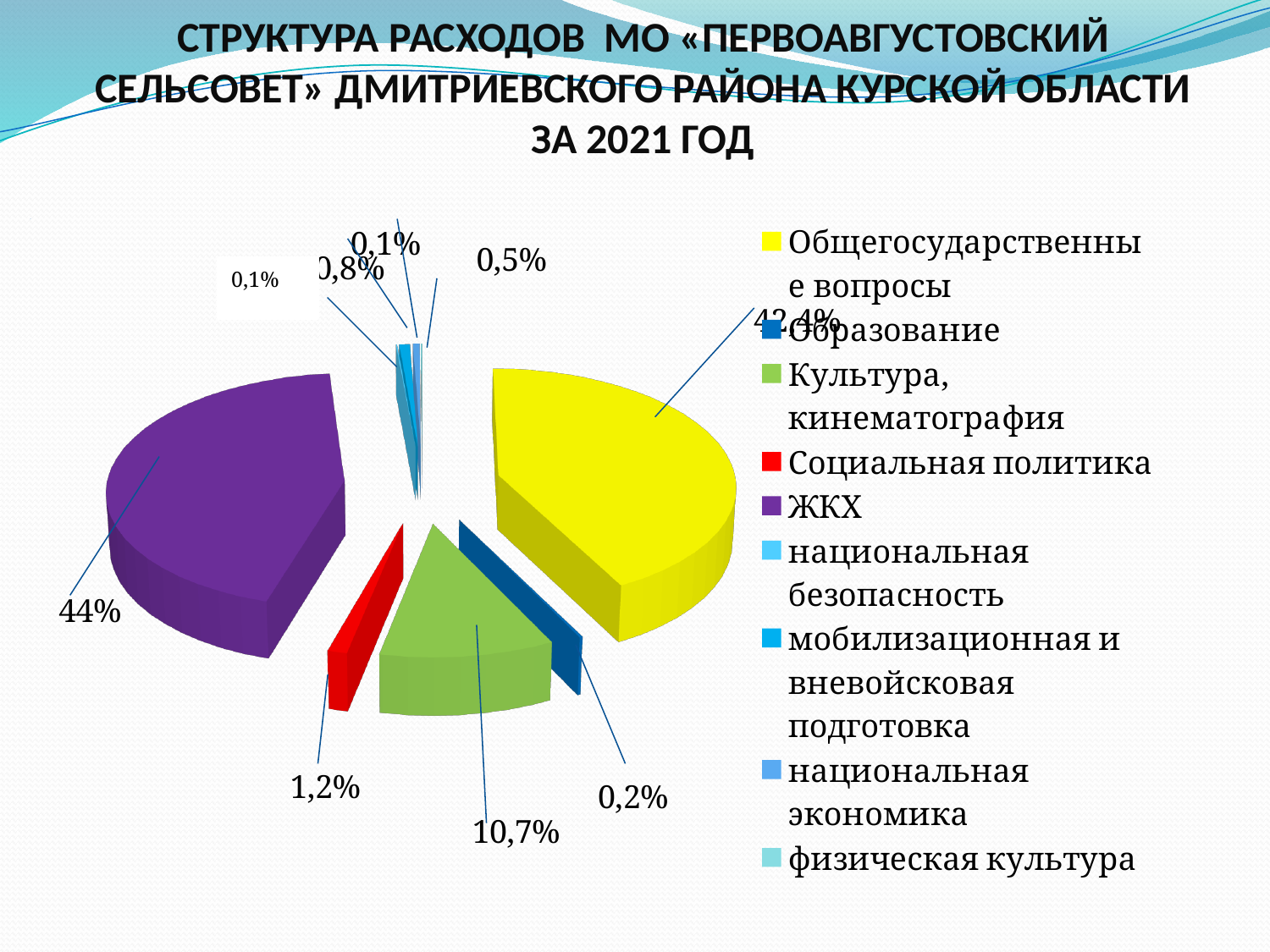
Which is larger: the share for Культура, кинематография or the share for Социальная политика? Культура, кинематография How many categories does the legend of the pie chart list? 9 What is the difference between the shares for ЖКХ and Культура, кинематография? 33,3% What is the value shown for Культура, кинематография? 10,7% What colour is the ЖКХ slice in the pie chart? purple What is the difference between the shares for Культура, кинематография and Социальная политика? 9,5% What is the value shown for Образование? 0,2% What is the value shown for Социальная политика? 1,2% Which is larger: the share for ЖКХ or the share for Общегосударственные вопросы? ЖКХ What share of expenditures does ЖКХ account for? 44% Which category has the largest share of the pie? ЖКХ What kind of chart is shown on the slide? pie chart